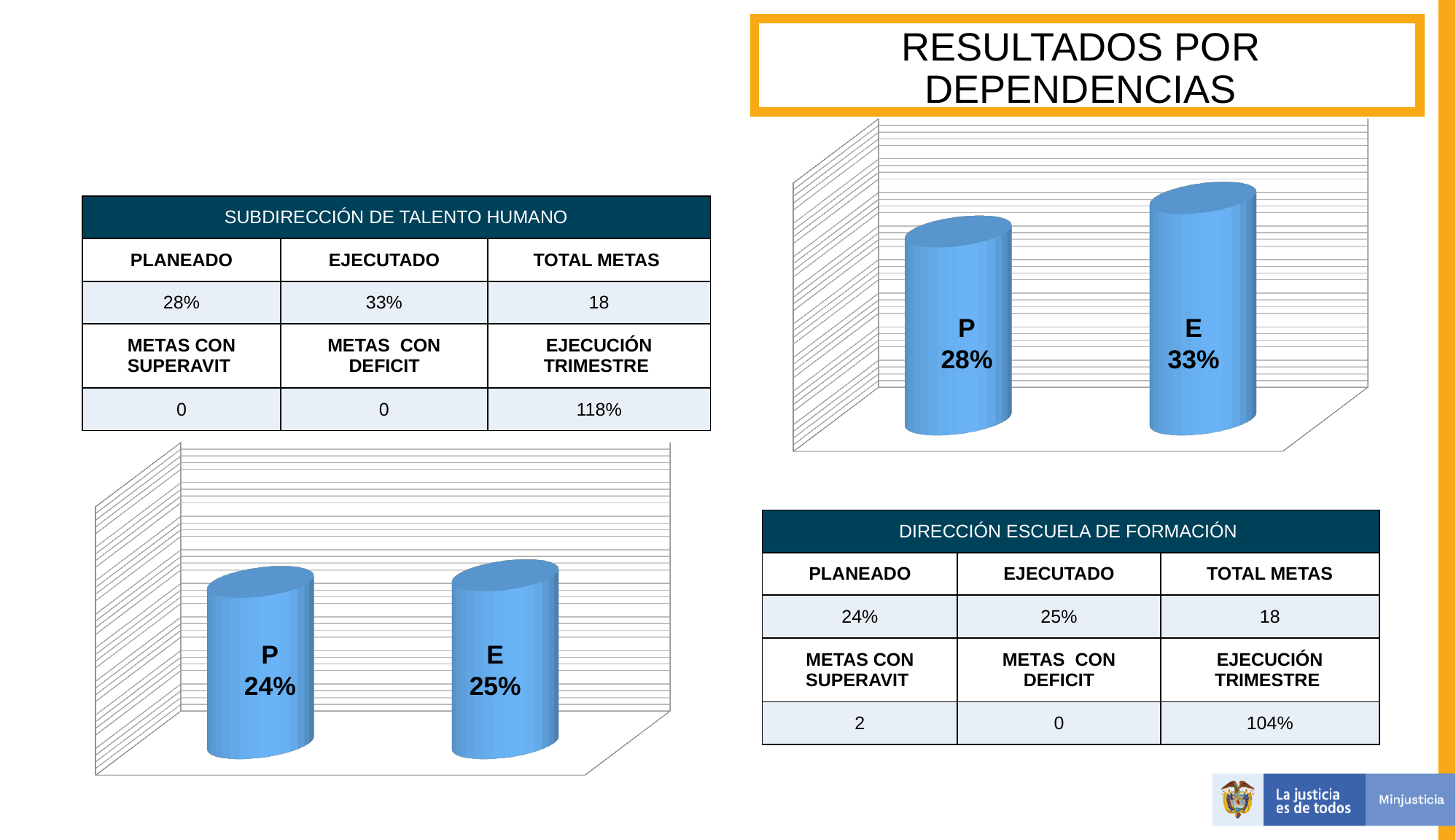
In the chart at the top right of the slide, which bar is higher, P or E? E In the chart at the bottom left of the slide, what is the value for E? 25% In the chart at the top right of the slide, what is the value for E? 33% In the chart at the bottom left of the slide, which bar has the lowest value? P What kind of chart is shown at the bottom left of the slide? Bar chart How many charts are shown on the slide? 2 What colour are the bars in the chart at the top right of the slide? Blue In the chart at the bottom left of the slide, what is the value for P? 24% In the chart at the top right of the slide, how many bars are plotted? 2 In the chart at the top right of the slide, what is the difference between the values for E and P? 5% In the chart at the top right of the slide, what is the value for P? 28% In the chart at the bottom left of the slide, what is the difference between the values for E and P? 1%